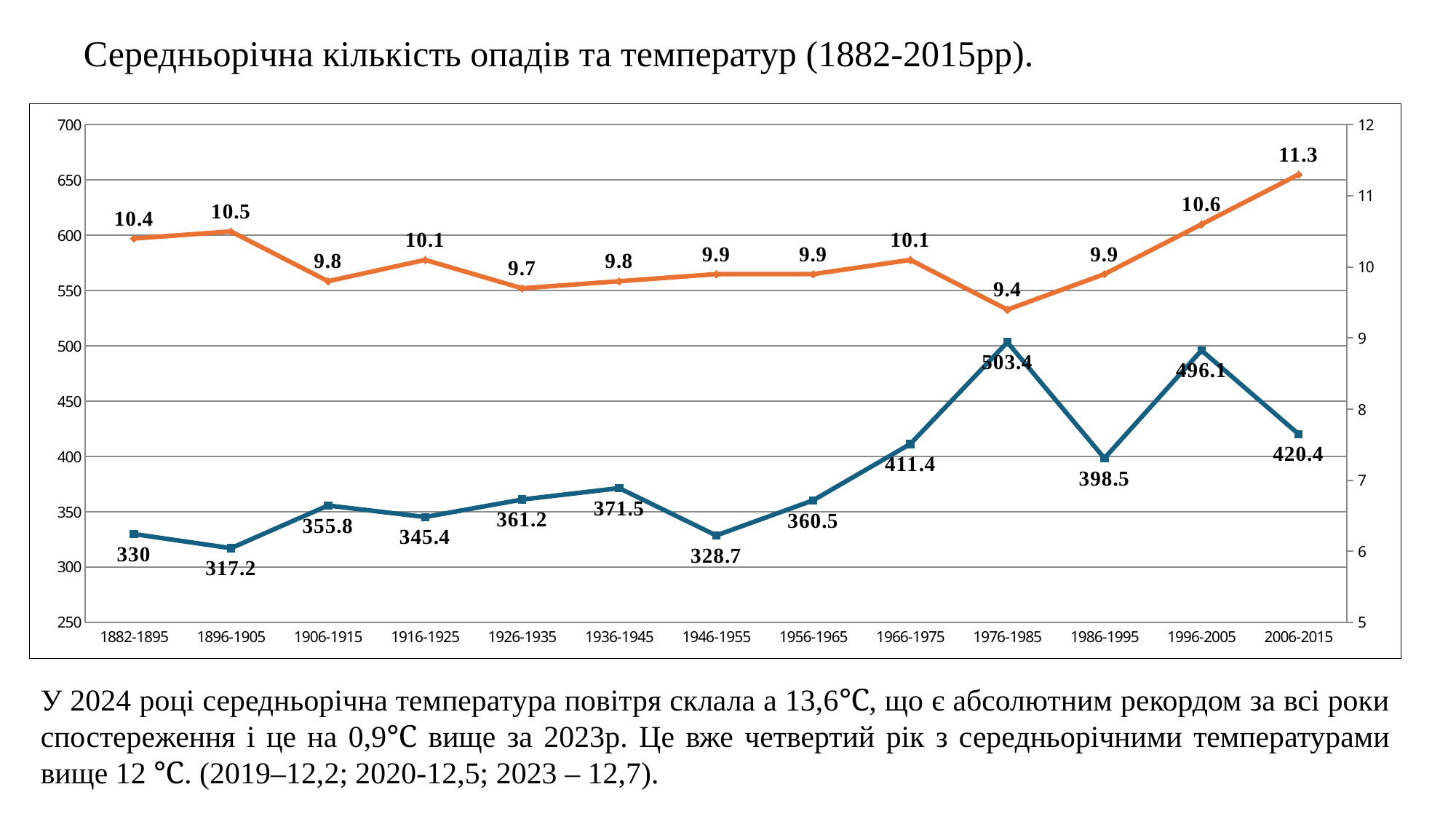
What is the value of the orange line for the period 2006-2015? 11.3 In which period does the blue line reach its highest value? 1976-1985 What is the difference between the blue line values for 1976-1985 and 1986-1995? 104.9 What kind of chart is shown on the slide? line chart In which period does the blue line have its lowest value? 1896-1905 What is the value of the blue line for the period 1976-1985? 503.4 Which period has the larger orange line value, 1882-1895 or 1896-1905? 1896-1905 What is the value of the blue line for the period 1946-1955? 328.7 In which period does the orange line reach its highest value? 2006-2015 In which period does the orange line have its lowest value? 1976-1985 How many time periods are shown along the x axis of the chart? 13 What is the title of the slide above the chart? Середньорічна кількість опадів та температур (1882-2015рр).